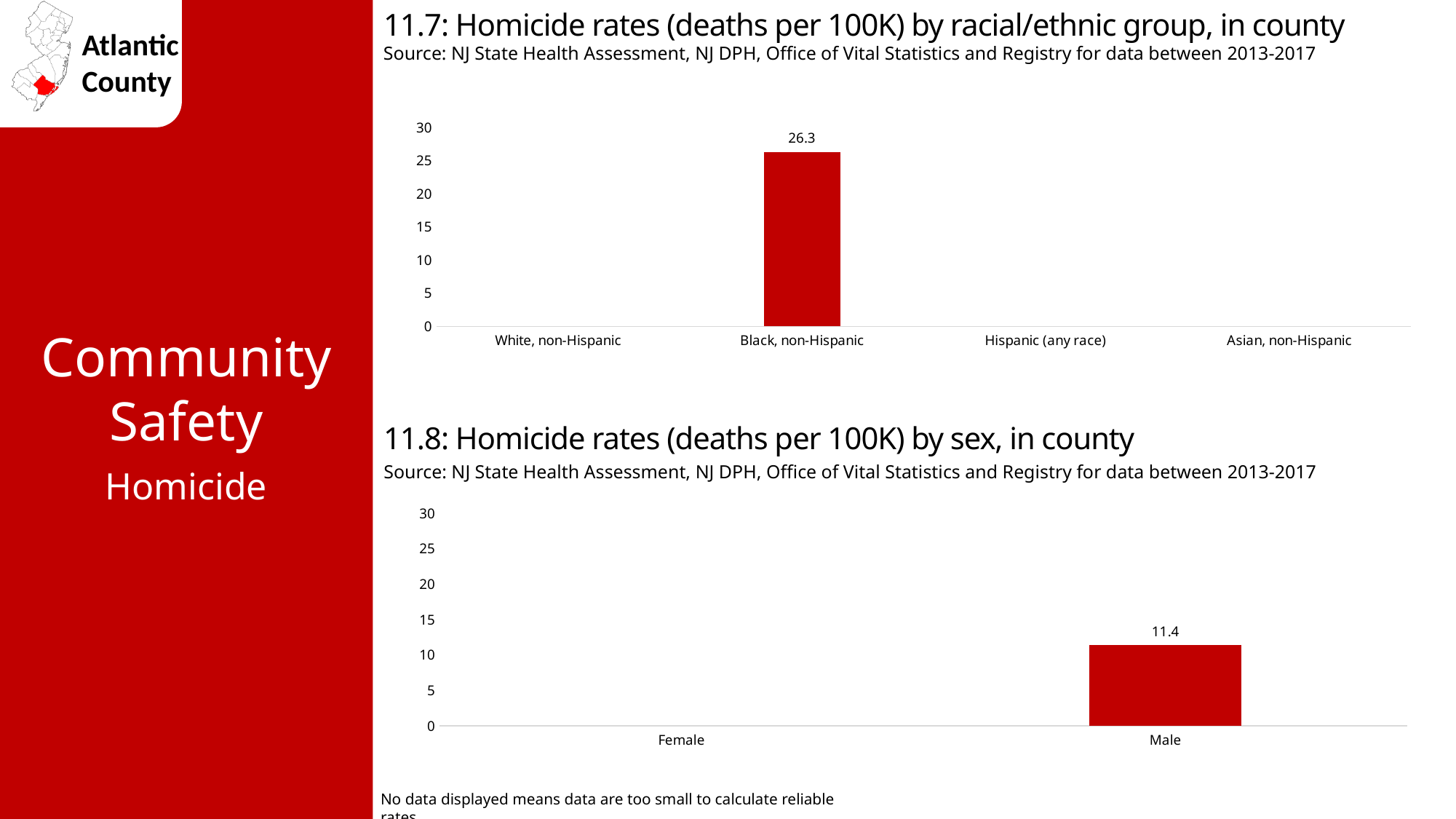
In the chart '11.7: Homicide rates (deaths per 100K) by racial/ethnic group, in county', what is the homicide rate for Black, non-Hispanic? 26.3 In the top chart (11.7), which racial/ethnic group has the highest homicide rate displayed? Black, non-Hispanic According to the note at the bottom of the slide, what does no data displayed mean? Data are too small to calculate reliable rates In the bottom chart (11.8), is the value for Male greater or less than 10? greater In the chart '11.8: Homicide rates (deaths per 100K) by sex, in county', what is the homicide rate for Male? 11.4 In the bottom chart (11.8), how many categories are listed on the x axis? 2 In the bottom chart (11.8), which sex has a homicide rate displayed? Male What is the difference between the Black, non-Hispanic rate in the top chart (11.7) and the Male rate in the bottom chart (11.8)? 14.9 What kind of chart is the top chart (11.7)? Bar chart In the top chart (11.7), is the value for Black, non-Hispanic greater or less than 25? greater In the top chart (11.7), how many racial/ethnic group categories are listed on the x axis? 4 What is the maximum value shown on the y axis of the bottom chart (11.8)? 30